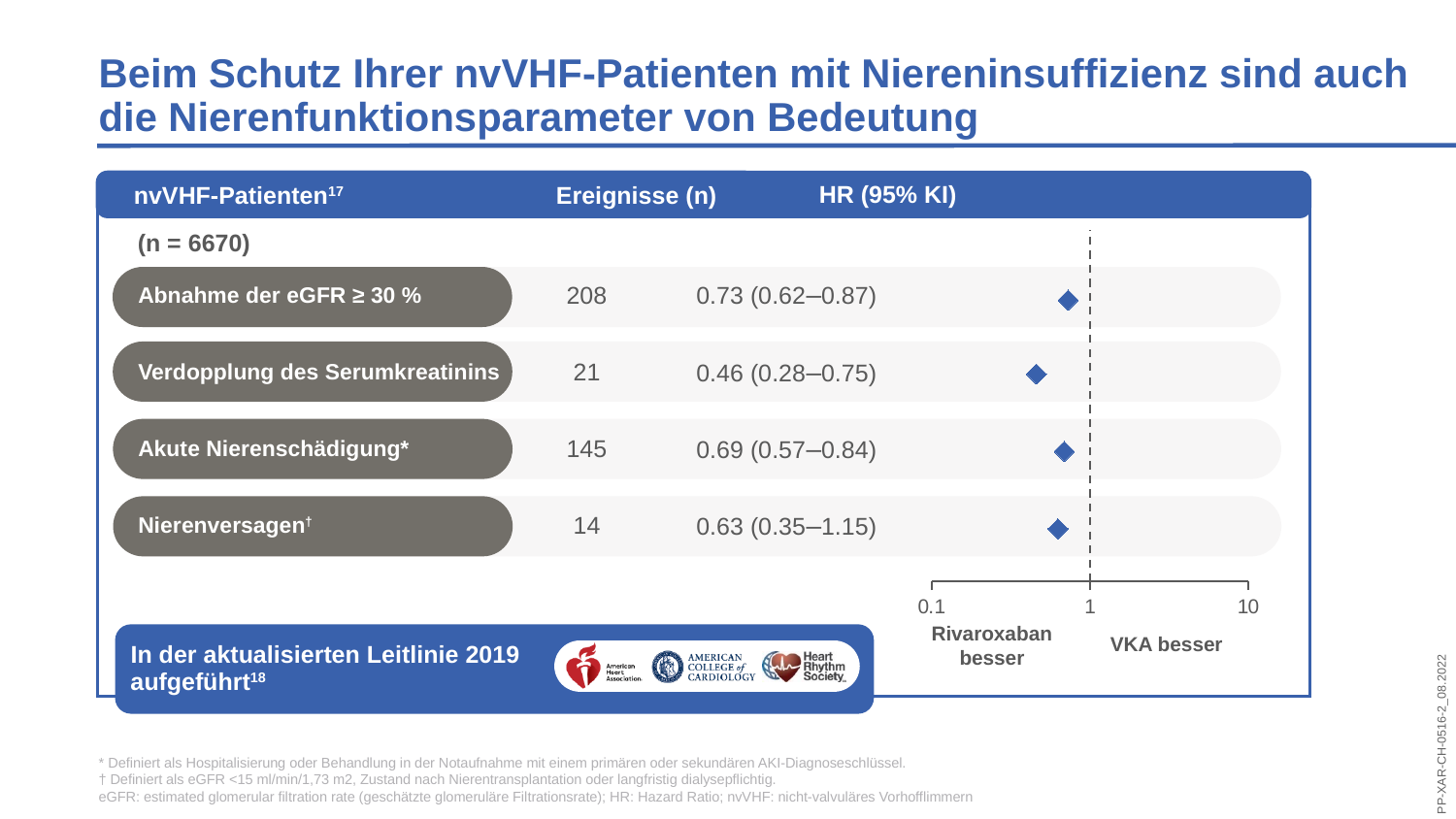
How many events (Ereignisse) are reported for "Akute Nierenschädigung"? 145 What is the hazard ratio (95% KI) for "Verdopplung des Serumkreatinins"? 0.46 (0.28–0.75) How many events are reported for "Nierenversagen"? 14 What label appears under the left side of the hazard ratio axis? Rivaroxaban besser Which outcome has the lowest hazard ratio point estimate? Verdopplung des Serumkreatinins Which outcome has the highest number of events? Abnahme der eGFR ≥ 30 % What is the difference in the number of events between "Abnahme der eGFR ≥ 30 %" and "Akute Nierenschädigung"? 63 Is the hazard ratio point estimate for "Nierenversagen" greater or less than 1? less Which has the larger hazard ratio point estimate: "Akute Nierenschädigung" or "Nierenversagen"? Akute Nierenschädigung How many outcomes are plotted in the forest plot? 4 What kind of chart is shown on the slide? Forest plot What is the hazard ratio (95% KI) shown for "Abnahme der eGFR ≥ 30 %"? 0.73 (0.62–0.87)